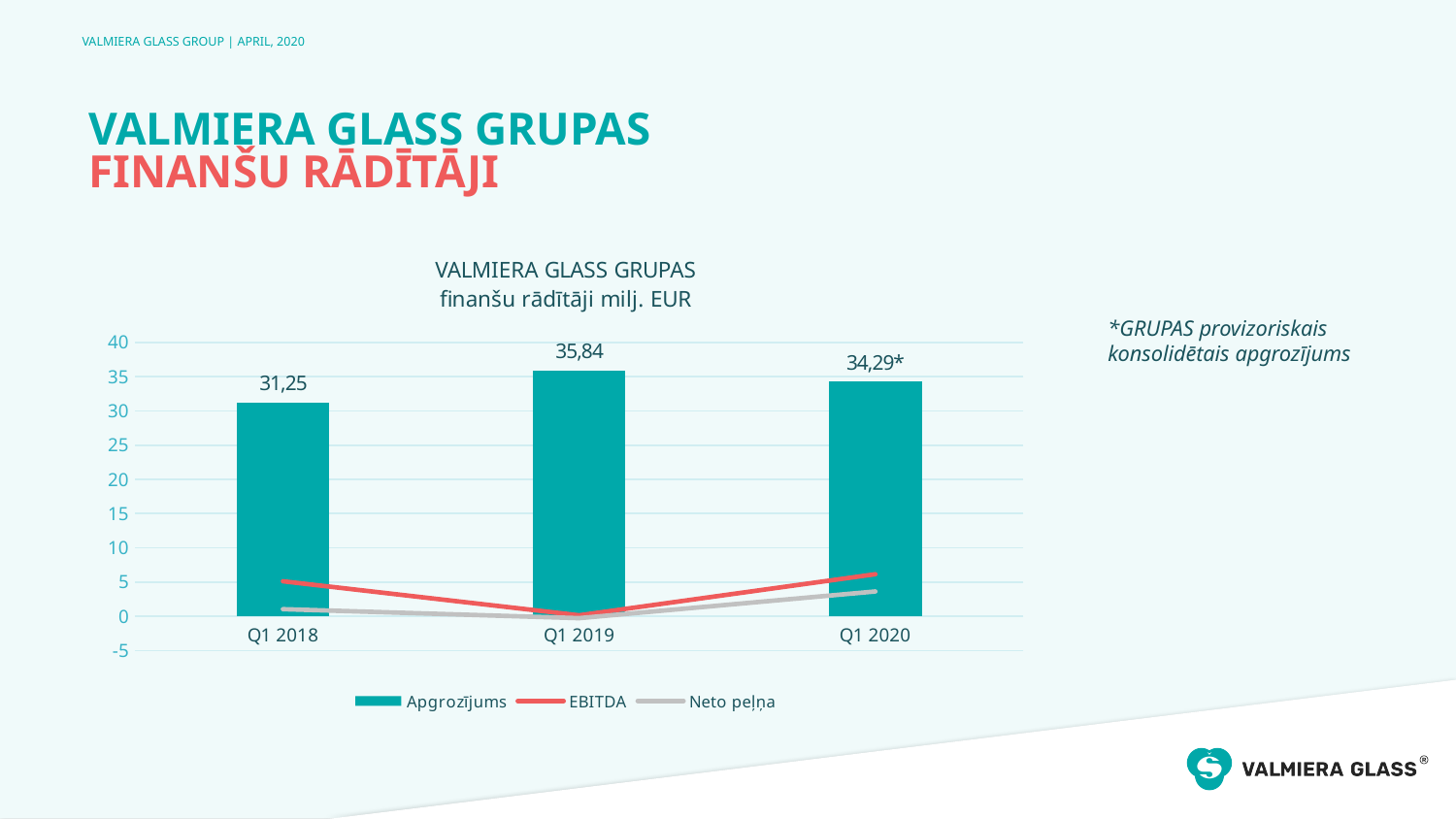
What is the Apgrozījums value shown for Q1 2020? 34,29* What is the Apgrozījums value for Q1 2019? 35,84 What kind of chart is this? Combined bar and line chart What is the title of the chart? VALMIERA GLASS GRUPAS finanšu rādītāji milj. EUR How many series does the legend list? 3 In which quarter is Apgrozījums highest? Q1 2019 How many quarters are shown on the x axis? 3 What is the Apgrozījums value for Q1 2018? 31,25 Is the EBITDA value for Q1 2019 greater or less than 5? less What is the difference between the Apgrozījums values for Q1 2019 and Q1 2018? 4,59 In which quarter is Apgrozījums lowest? Q1 2018 Which is larger, the Apgrozījums for Q1 2020 or for Q1 2018? Q1 2020